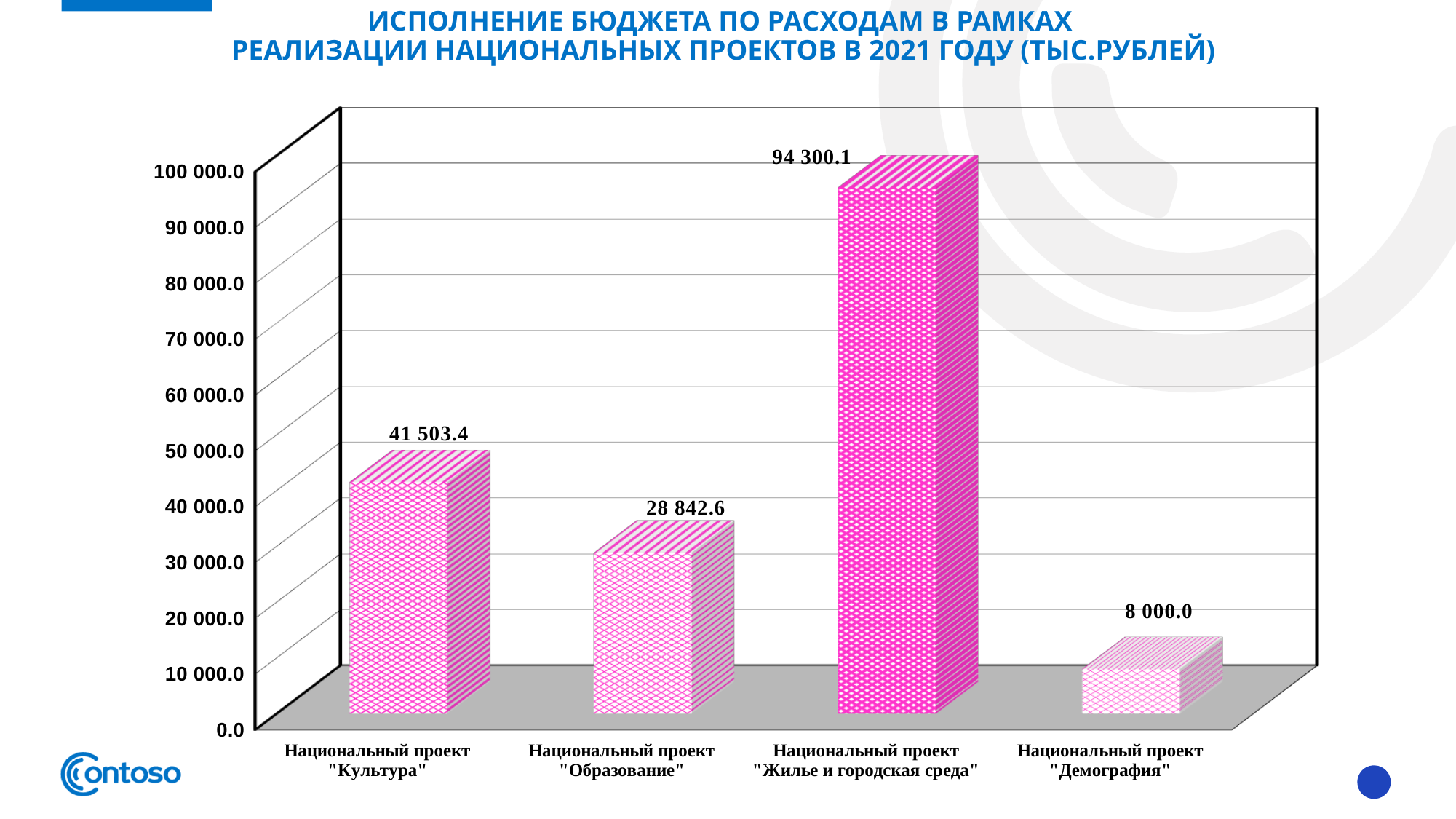
What is the value for the national project "Культура"? 41 503.4 Which is larger, the value for "Образование" or the value for "Демография"? Национальный проект "Образование" How many national projects are shown on the chart? 4 What is the unit of measurement stated in the chart title? тыс.рублей What kind of chart is shown on the slide? Bar chart What is the value for the national project "Жилье и городская среда"? 94 300.1 Which national project has the lowest value? Национальный проект "Демография" What is the difference between the values for "Жилье и городская среда" and "Культура"? 52 796.7 What is the value for the national project "Демография"? 8 000.0 What is the difference between the values for "Культура" and "Образование"? 12 660.8 Which national project has the highest value? Национальный проект "Жилье и городская среда" What is the value for the national project "Образование"? 28 842.6